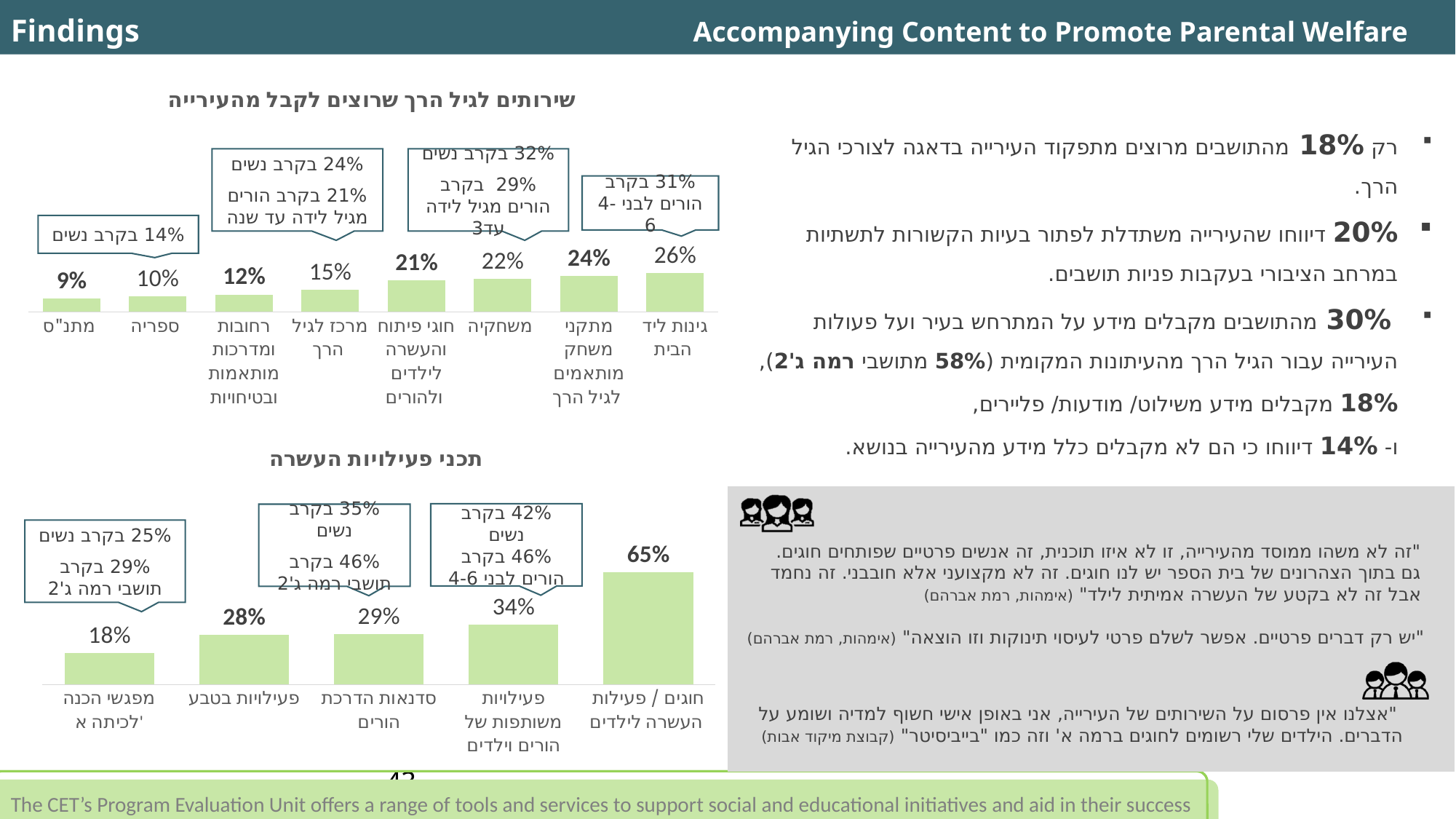
How many categories are shown in the top chart (שירותים לגיל הרך שרוצים לקבל מהעירייה)? 8 In the bottom chart (תכני פעילויות העשרה), what is the value for פעילויות בטבע? 28% In the bottom chart (תכני פעילויות העשרה), which is larger: פעילויות משותפות של הורים וילדים or סדנאות הדרכת הורים? פעילויות משותפות של הורים וילדים In the bottom chart (תכני פעילויות העשרה), what is the difference between חוגים / פעילות העשרה לילדים and פעילויות משותפות של הורים וילדים? 31% In the top chart (שירותים לגיל הרך שרוצים לקבל מהעירייה), what is the difference between מרכז לגיל הרך and ספריה? 5% In the bottom chart (תכני פעילויות העשרה), what is the value for חוגים / פעילות העשרה לילדים? 65% In the top chart (שירותים לגיל הרך שרוצים לקבל מהעירייה), which category has the highest value? גינות ליד הבית In the bottom chart (תכני פעילויות העשרה), which category has the lowest value? מפגשי הכנה לכיתה א' In the top chart (שירותים לגיל הרך שרוצים לקבל מהעירייה), what is the value for משחקיה? 22% In the top chart (שירותים לגיל הרך שרוצים לקבל מהעירייה), which category has the lowest value? מתנ"ס What type of chart is the bottom chart (תכני פעילויות העשרה)? Bar chart In the top chart (שירותים לגיל הרך שרוצים לקבל מהעירייה), what is the value for גינות ליד הבית? 26%